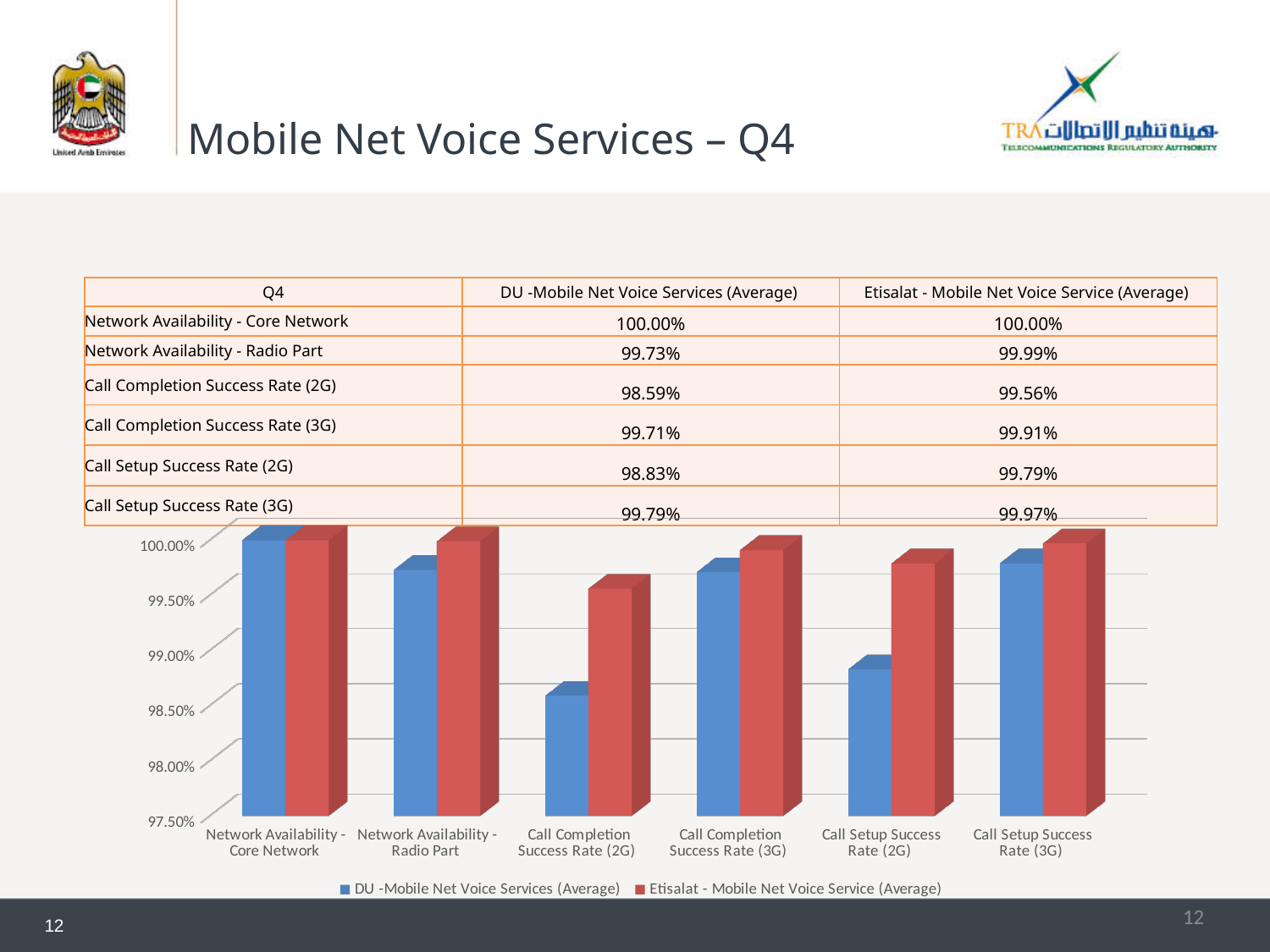
How many categories are plotted along the x axis of the chart? 6 Which colour represents the Etisalat series in the chart? red What is the DU value for Network Availability - Radio Part? 99.73% How many series does the chart legend list? 2 What is the DU value for Call Completion Success Rate (2G)? 98.59% What is the Etisalat value for Call Setup Success Rate (3G)? 99.97% Which category has the lowest Etisalat value? Call Completion Success Rate (2G) What kind of chart is shown on the slide? bar chart Is the DU value for Call Setup Success Rate (2G) greater or less than 99.00%? less For Call Completion Success Rate (3G), which is larger, the DU value or the Etisalat value? Etisalat Which category has the lowest DU value? Call Completion Success Rate (2G) What is the difference between the Etisalat and DU values for Call Setup Success Rate (2G)? 0.96%